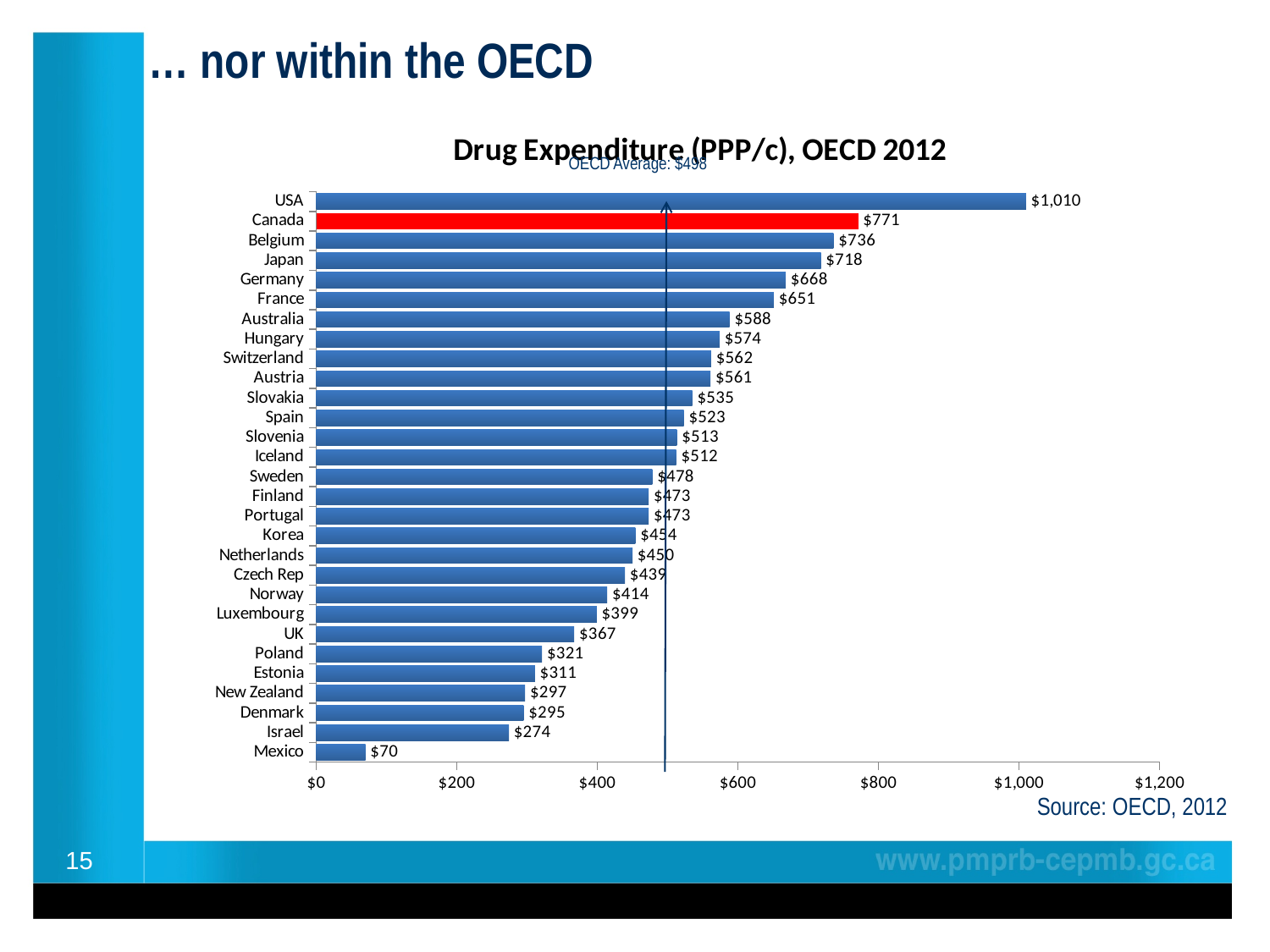
What is the OECD average drug expenditure indicated on the chart? $498 Which country has the lowest drug expenditure in the chart? Mexico Which country has the highest drug expenditure in the chart? USA What is the drug expenditure value shown for Canada? $771 What kind of chart is shown on the slide? Bar chart Is the value for Australia greater or less than $600? less What is the drug expenditure value shown for Germany? $668 What is the drug expenditure value shown for the UK? $367 Which has a higher drug expenditure value, Japan or France? Japan What is the difference between the USA's and Canada's drug expenditure values? $239 Which country's bar is coloured red in the chart? Canada How many countries are shown in the chart? 29